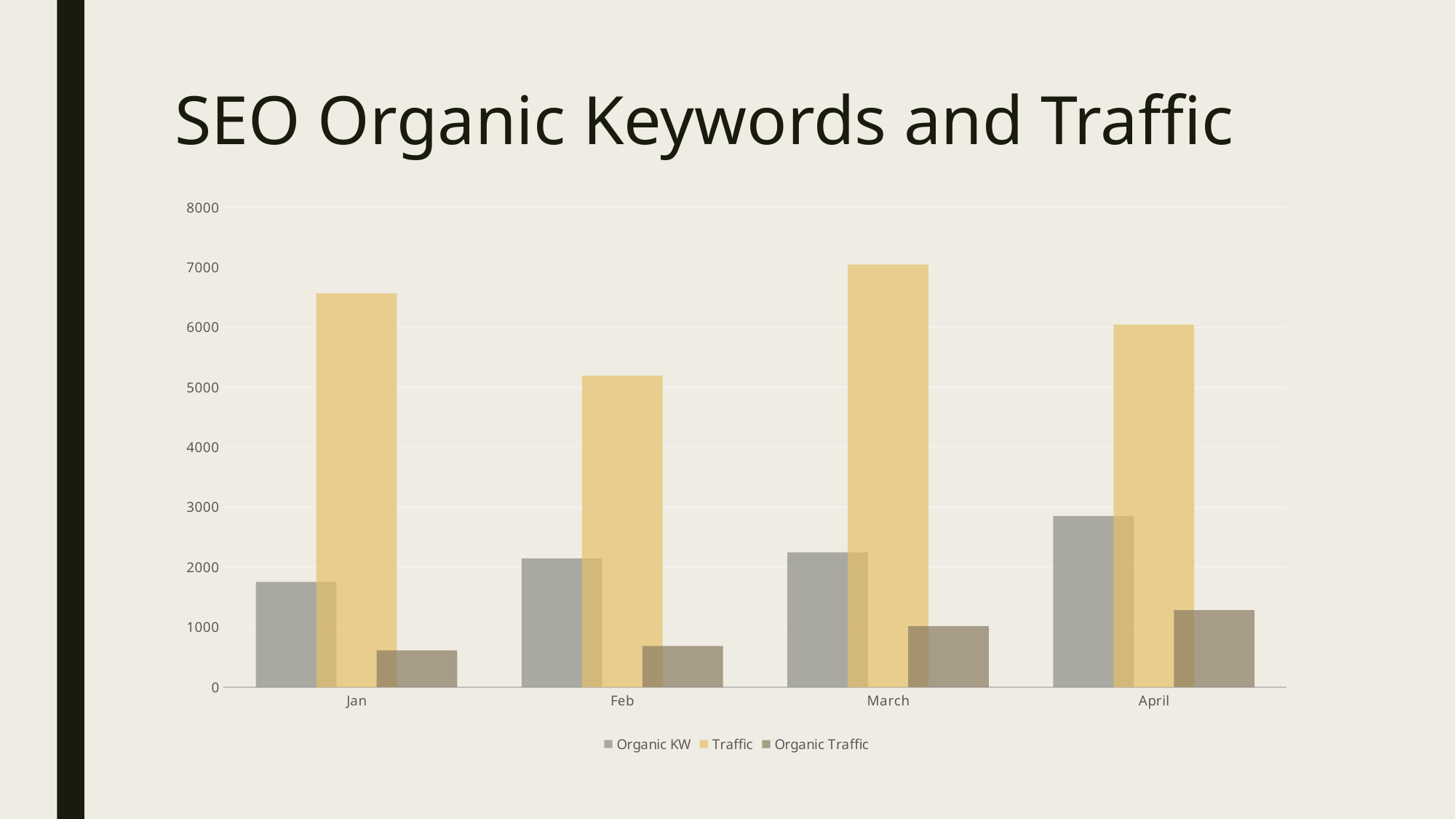
How many series does the chart's legend list? 3 Is the Organic Traffic value for Feb greater or less than 1000? less In which month is Organic KW highest? April How many months are shown on the x axis of the chart? 4 In which month is Traffic highest? March What kind of chart is shown on the slide? bar chart Does Organic Traffic rise or fall from Jan to April? rise In which month is Traffic lowest? Feb Which is larger, Traffic in Jan or Traffic in April? Jan Is the Traffic value for Jan greater or less than 6000? greater Is the Organic KW value for April greater or less than 3000? less In which month is Organic Traffic highest? April